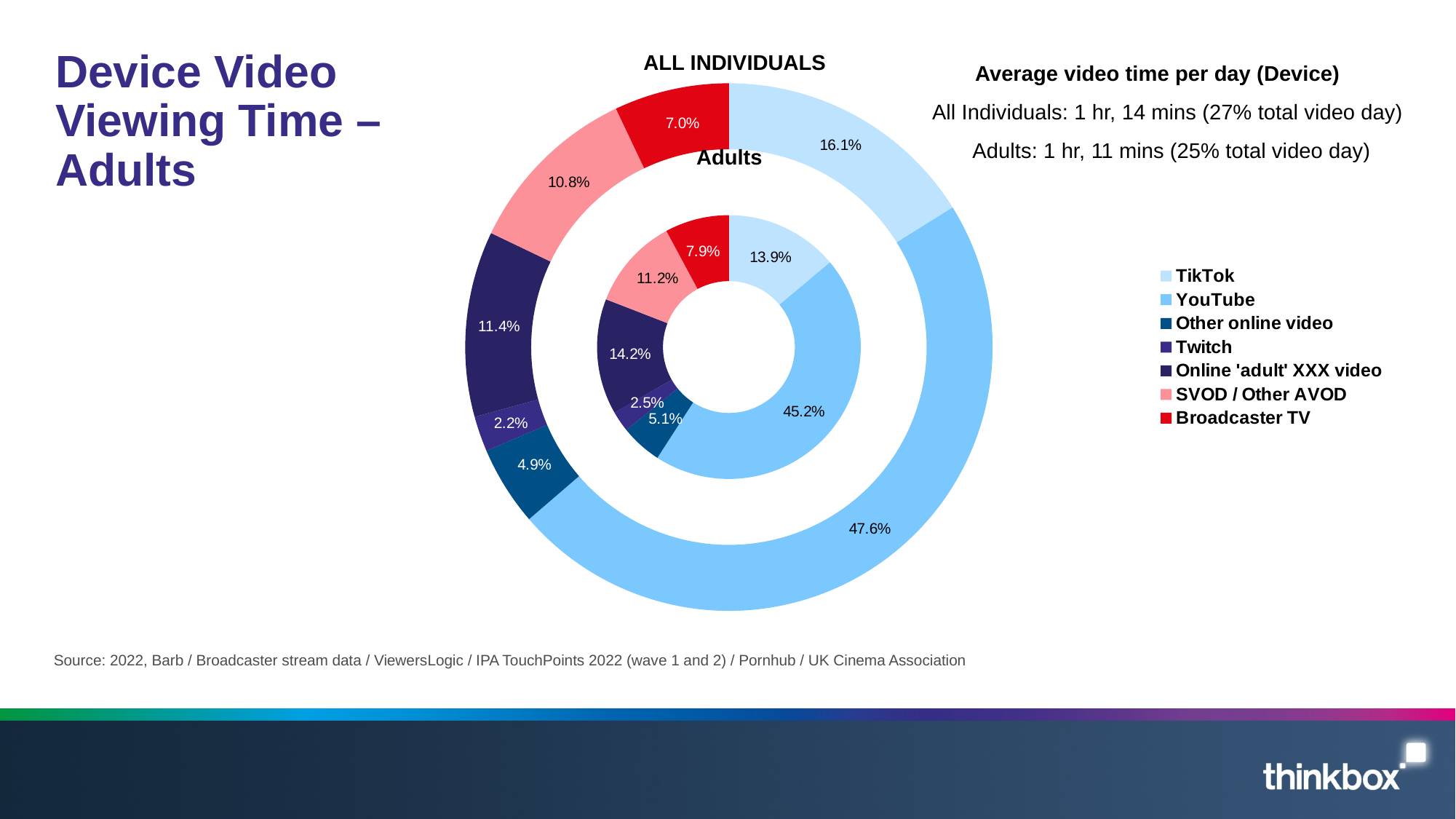
Which ring of the doughnut chart represents Adults, the inner or the outer? Inner Which category has the largest share in the All Individuals ring? YouTube What kind of chart is shown on the slide? Doughnut chart What is the difference between the YouTube share for All Individuals and for Adults? 2.4% How many categories does the legend list? 7 Which is larger in the Adults ring: SVOD / Other AVOD or Broadcaster TV? SVOD / Other AVOD In the All Individuals ring, what share does Broadcaster TV have? 7.0% In the Adults ring, what share does Online 'adult' XXX video have? 14.2% Which category has the smallest share in the Adults ring? Twitch In the Adults ring, what share does TikTok have? 13.9% What is the difference between the Twitch share for Adults and for All Individuals? 0.3% In the All Individuals ring, what share does YouTube have? 47.6%